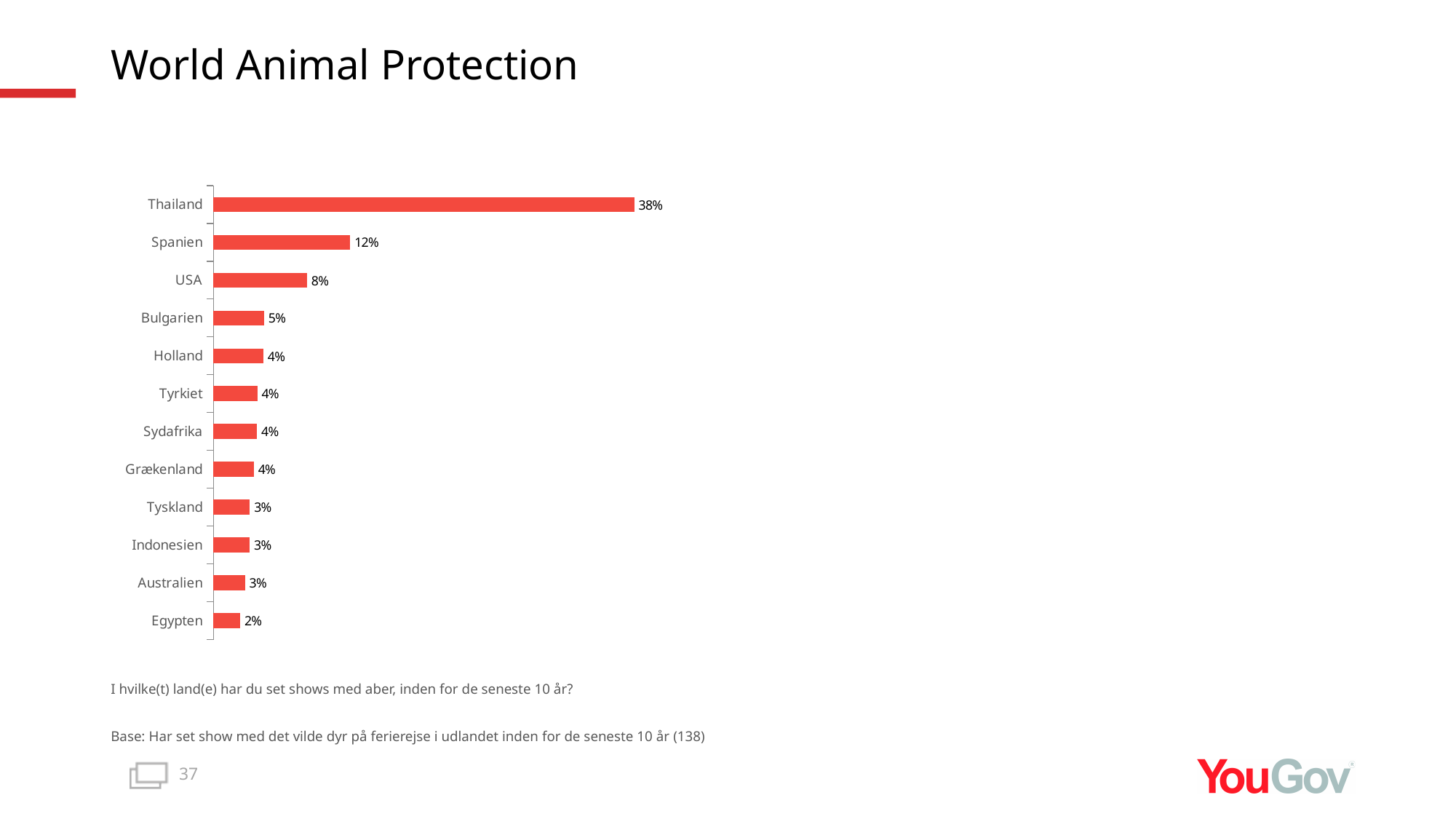
What is the value for Spanien? 12% What percentage is shown for Thailand? 38% How many countries are shown in the chart? 12 What type of chart is shown on the slide? Bar chart What percentage is shown for USA? 8% What is the value for Bulgarien? 5% What is the difference between the values for Thailand and Spanien? 26 percentage points Which country has the lowest value? Egypten What percentage is shown for Egypten? 2% Which country has the highest value? Thailand What colour are the bars in the chart? Red Which is larger, the value for USA or the value for Bulgarien? USA